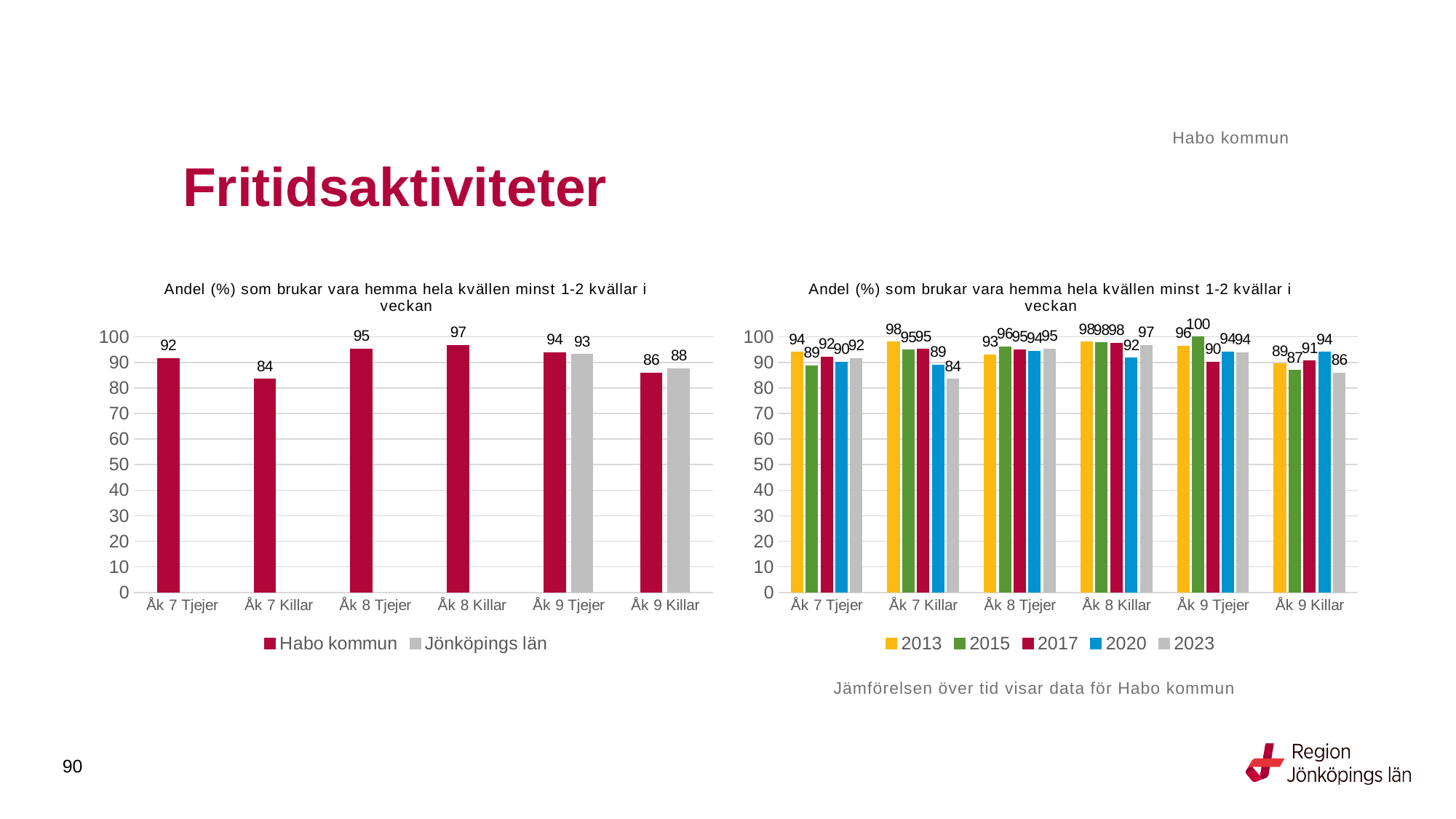
In the left chart, what is the value for Habo kommun for Åk 7 Killar? 84 In the right chart, which is larger for Åk 8 Tjejer: 2013 or 2015? 2015 In the left chart, what is the value for Jönköpings län for Åk 9 Killar? 88 In the right chart, how many series does the legend list? 5 What type of chart is the right chart? Bar chart In the left chart, which category has the lowest value for Habo kommun? Åk 7 Killar In the right chart, what is the value for 2023 for Åk 7 Killar? 84 In the left chart, how many series does the legend list? 2 In the right chart, what is the difference between 2013 and 2023 for Åk 7 Killar? 14 In the left chart, which category has the highest value for Habo kommun? Åk 8 Killar In the left chart, what is the difference between Habo kommun and Jönköpings län for Åk 9 Killar? 2 In the right chart, what is the value for 2015 for Åk 9 Tjejer? 100